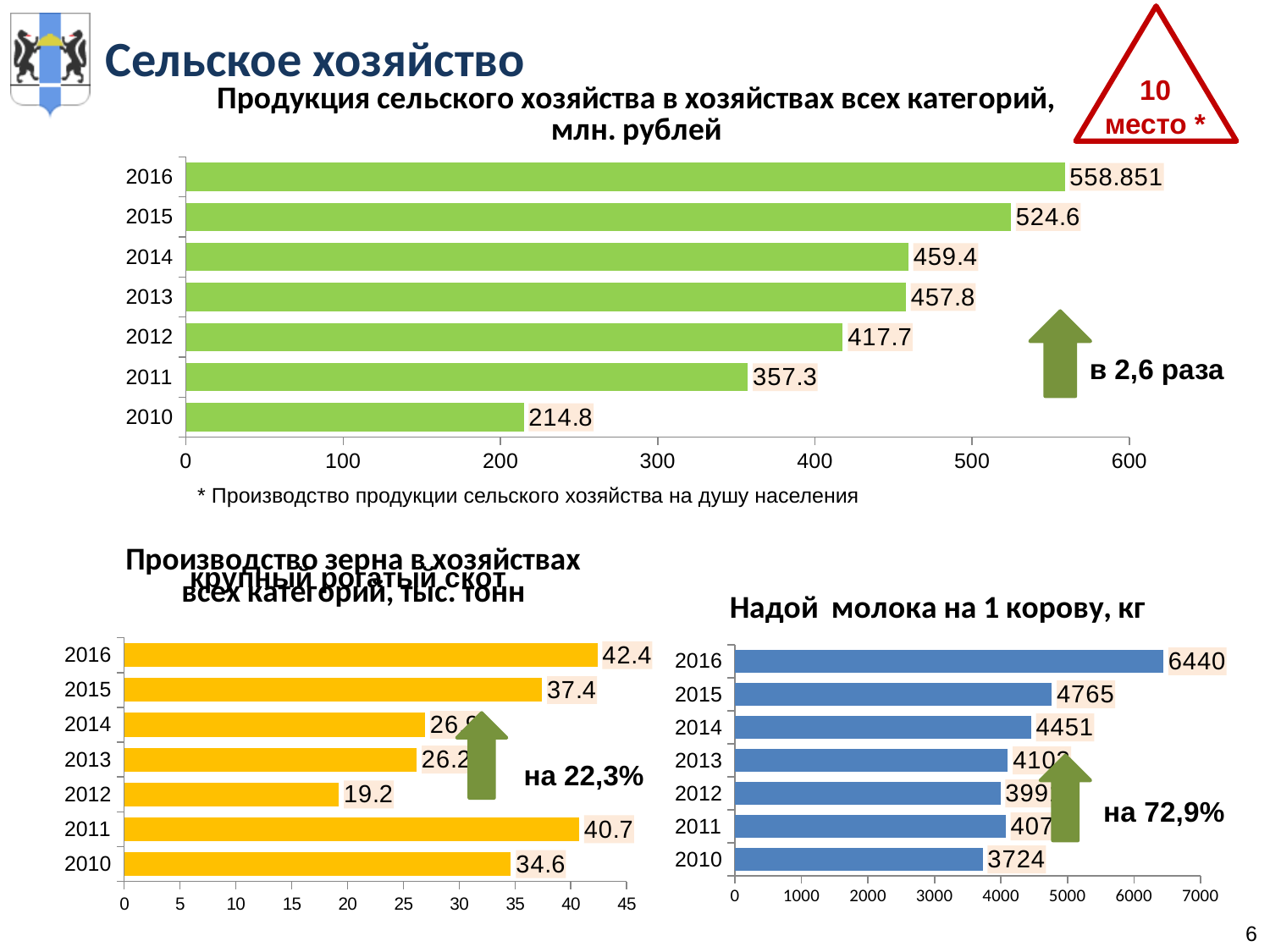
In the top chart 'Продукция сельского хозяйства в хозяйствах всех категорий, млн. рублей', which year has the lowest value? 2010 In the top chart 'Продукция сельского хозяйства в хозяйствах всех категорий, млн. рублей', what is the value for 2010? 214.8 In the top chart 'Продукция сельского хозяйства в хозяйствах всех категорий, млн. рублей', what is the value for 2016? 558.851 What kind of chart is the top chart 'Продукция сельского хозяйства в хозяйствах всех категорий, млн. рублей'? bar chart In the chart 'Надой молока на 1 корову, кг', what is the value for 2016? 6440 In the top chart 'Продукция сельского хозяйства в хозяйствах всех категорий, млн. рублей', what is the difference between the 2015 and 2012 values? 106.9 In the top chart 'Продукция сельского хозяйства в хозяйствах всех категорий, млн. рублей', do the values rise or fall from 2010 to 2016? rise In the bottom-left chart (yellow bars), which is larger, the value for 2016 or the value for 2015? 2016 In the chart 'Надой молока на 1 корову, кг', what is the difference between the 2015 and 2010 values? 1041 In the top chart 'Продукция сельского хозяйства в хозяйствах всех категорий, млн. рублей', how many years are shown? 7 In the bottom-left chart (yellow bars), what is the value for 2011? 40.7 In the bottom-left chart (yellow bars), which year has the lowest value? 2012